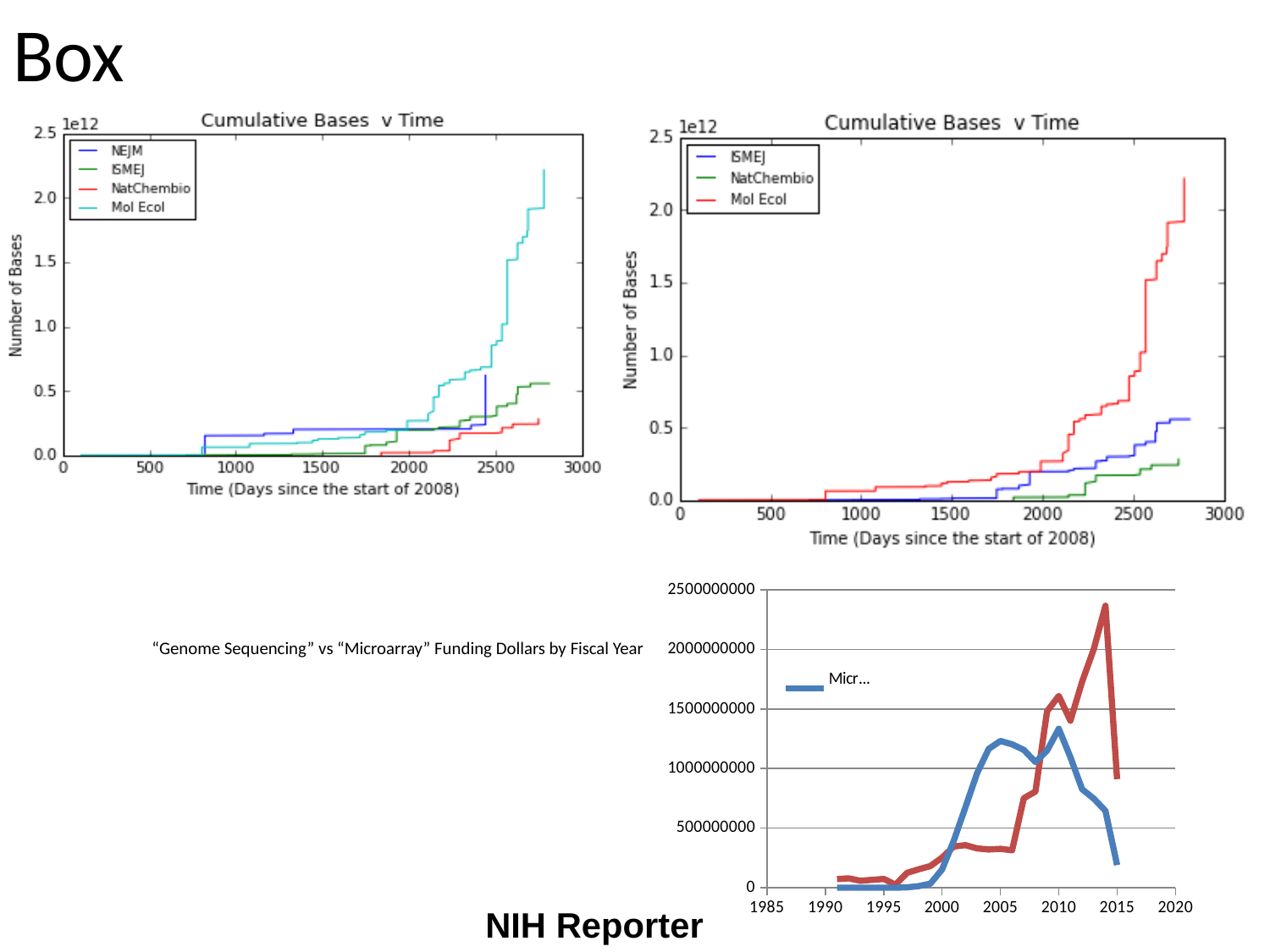
In the bottom-right funding chart, does the blue line rise or fall between 2010 and 2015? fall What kind of chart is the bottom-right "Genome Sequencing vs Microarray Funding Dollars by Fiscal Year" chart? line chart In the top-right "Cumulative Bases v Time" chart, which series reaches the highest number of bases? Mol Ecol In the bottom-right funding chart, is the peak value of the red line greater or less than 2000000000? greater In the top-right "Cumulative Bases v Time" chart, which series has the lowest number of bases at the end of the time range? NatChembio How many series does the legend of the top-right "Cumulative Bases v Time" chart list? 3 What kind of chart is the top-left "Cumulative Bases v Time" chart? line chart In the top-left "Cumulative Bases v Time" chart, which series is listed first in the legend? NEJM In the top-right "Cumulative Bases v Time" chart, is the final value for Mol Ecol greater or less than 2.0 (×1e12)? greater In the bottom-right funding chart, is the value of the blue line at 2015 greater or less than 500000000? less How many series does the legend of the top-left "Cumulative Bases v Time" chart list? 4